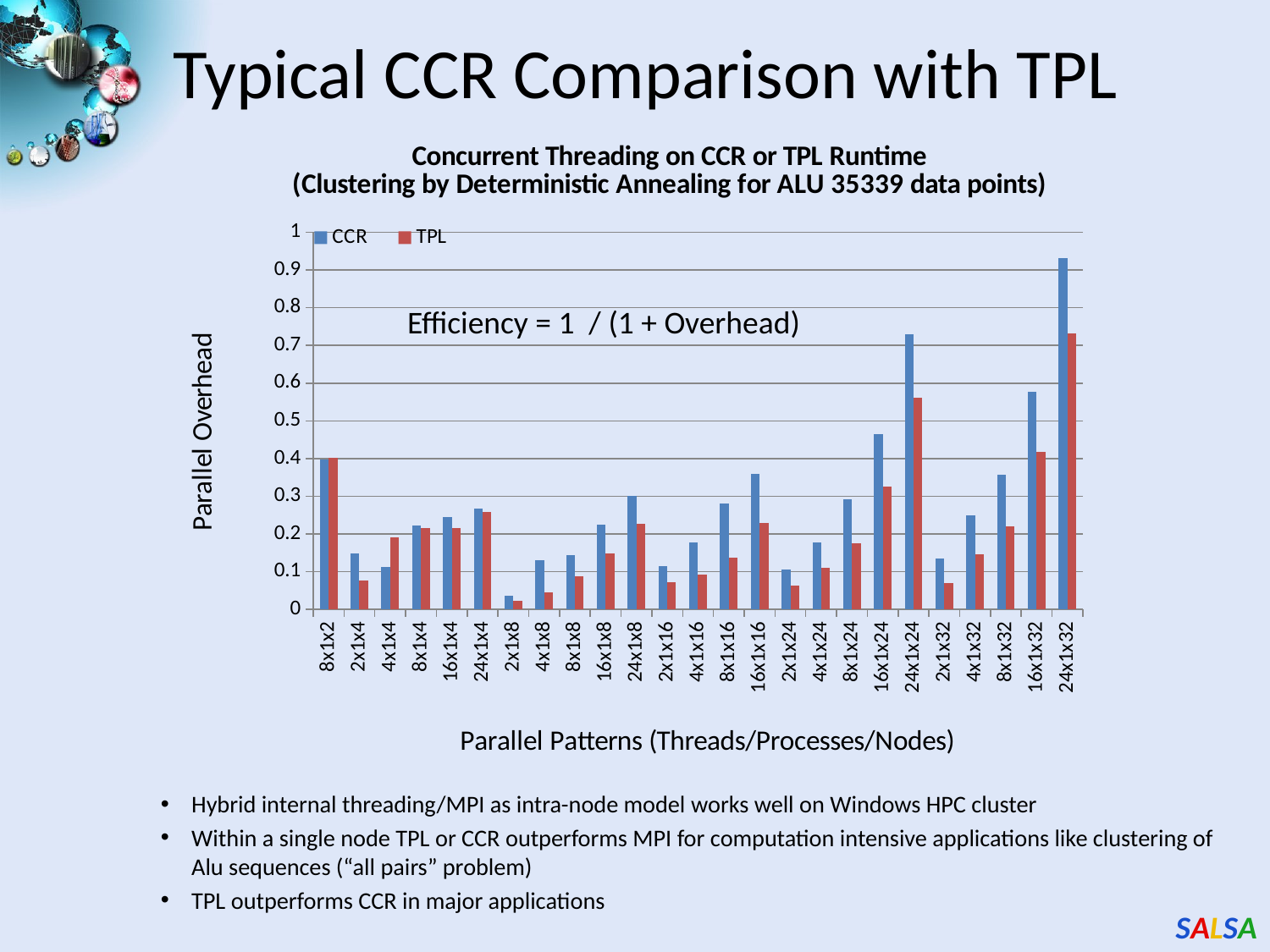
Is the CCR value for 16x1x24 greater or less than 0.5? less Is the TPL value for 2x1x4 greater or less than 0.1? less Which parallel pattern has the highest TPL parallel overhead? 24x1x32 Which parallel pattern has the lowest CCR parallel overhead? 2x1x8 Which parallel pattern has the highest CCR parallel overhead? 24x1x32 How many series does the legend list? 2 Is the CCR value for 24x1x32 greater or less than 0.8? greater For 16x1x32, which is larger, the CCR value or the TPL value? CCR How many parallel pattern categories are shown on the x axis? 25 What is the label of the y axis? Parallel Overhead What kind of chart is shown on the slide? bar chart